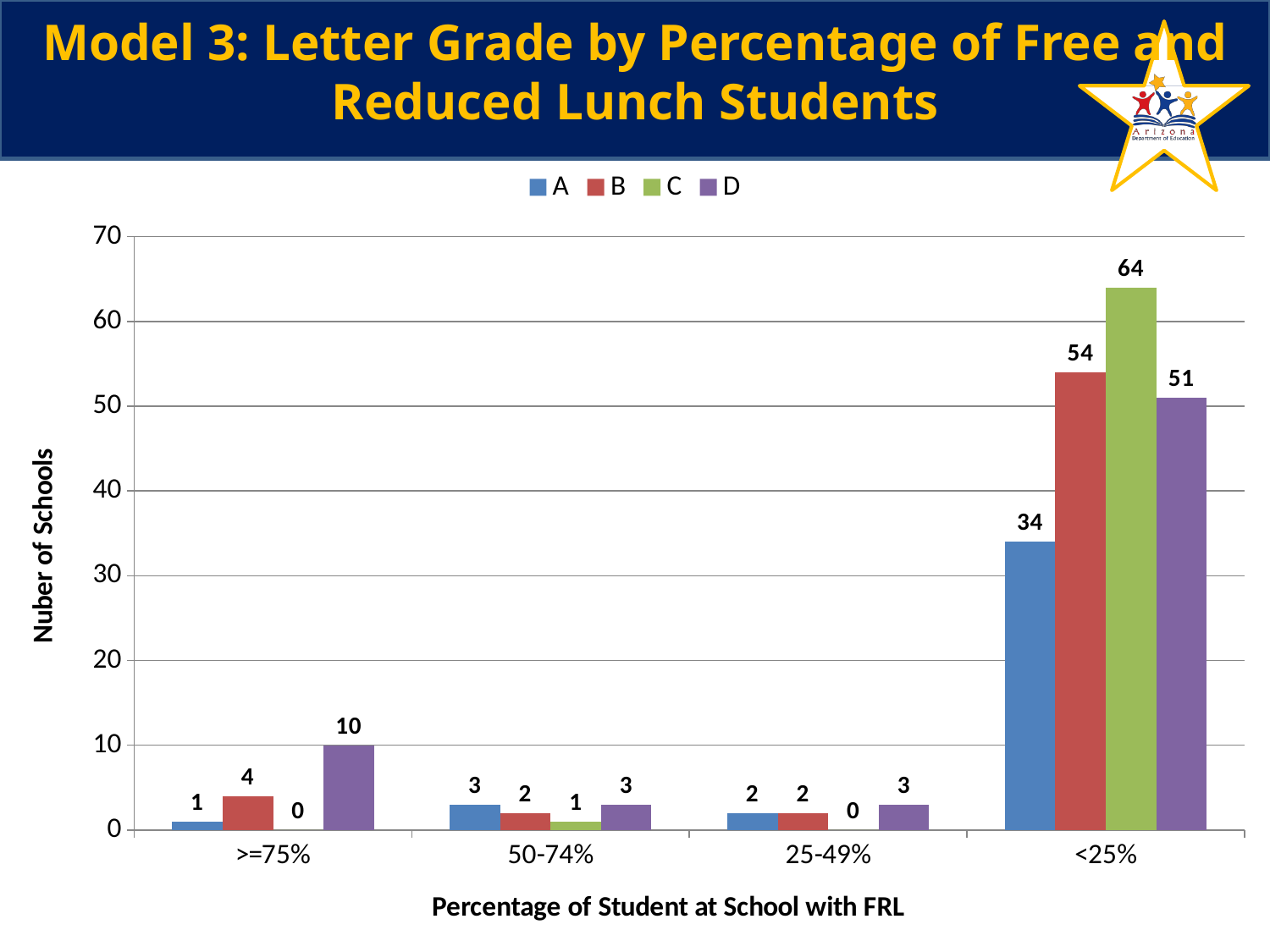
How many categories are shown on the x axis? 4 What is the value for series C in the 25-49% category? 0 Which series has the highest value in the <25% category? C How many series does the legend list? 4 What is the value for series A in the 50-74% category? 3 What is the value for series C in the <25% category? 64 Which series has the lowest value in the >=75% category? C What kind of chart is shown on the slide? bar chart What is the value for series D in the >=75% category? 10 What is the difference between series B and series A in the <25% category? 20 Is the value for series B in the <25% category greater or less than 50? greater In the <25% category, which is larger, series D or series A? D